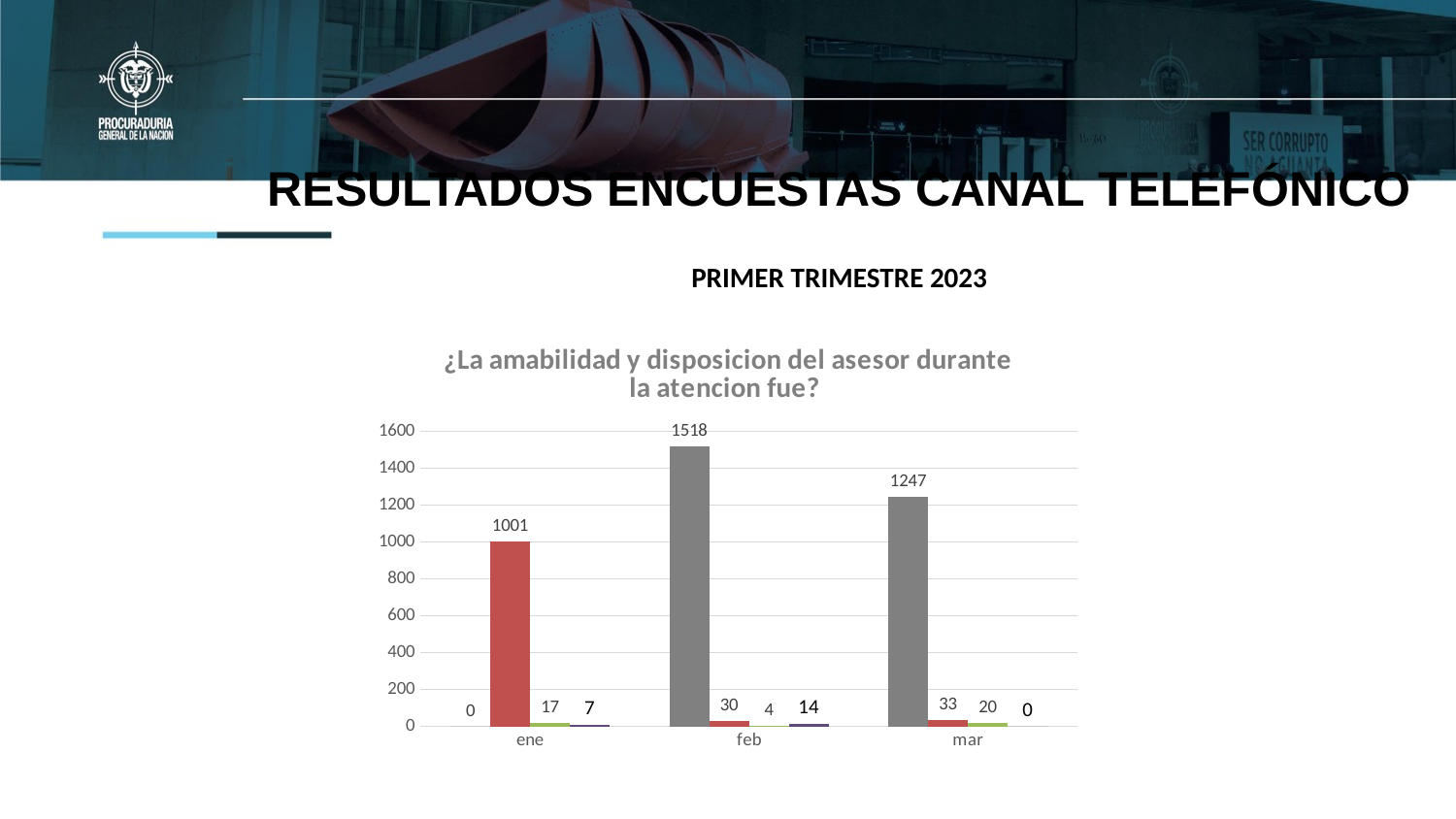
What is the value of the gray bar for feb? 1518 What is the difference between the gray bar for feb and the gray bar for mar? 271 What is the title of the chart? ¿La amabilidad y disposicion del asesor durante la atencion fue? What is the value of the red bar for mar? 33 What is the value of the gray bar for mar? 1247 What is the value of the purple bar for feb? 14 Which month has the highest labelled value in the chart? feb What is the value of the green bar for ene? 17 Which is larger, the red bar for feb or the red bar for mar? mar What is the value of the red bar for ene? 1001 What kind of chart is shown on the slide? bar chart How many month categories are shown on the x axis of the chart? 3